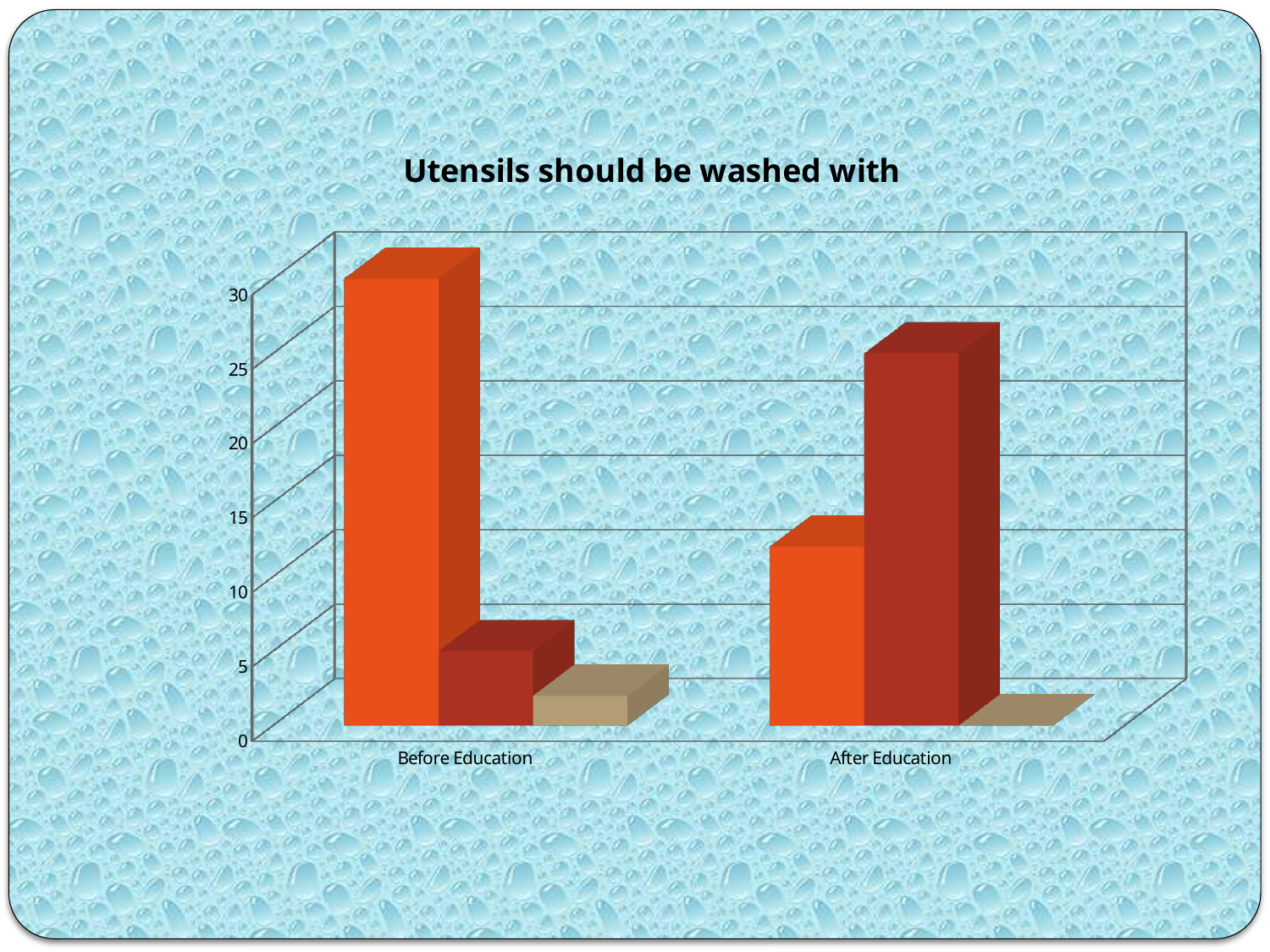
Is the value of the dark red bar for After Education greater or less than 20? greater What kind of chart is shown on the slide? bar chart Which category has the larger dark red bar, Before Education or After Education? After Education Is the value of the dark red bar for Before Education greater or less than 10? less Which category has the larger orange bar, Before Education or After Education? Before Education Does the orange series rise or fall from Before Education to After Education? fall Is the value of the orange bar for Before Education greater or less than 25? greater What is the title of the chart? Utensils should be washed with How many categories are shown on the x axis of the chart? 2